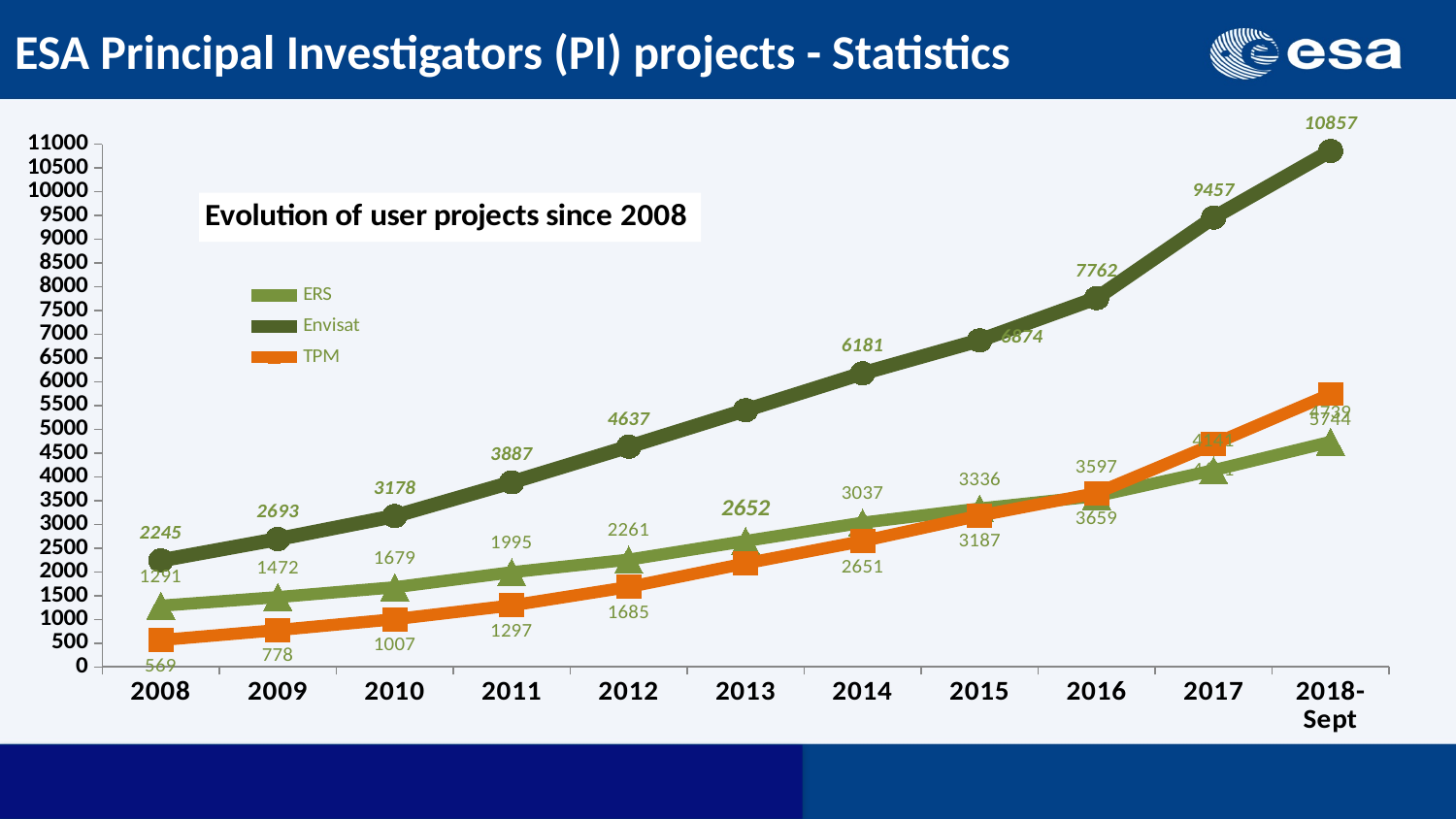
What is the difference between the Envisat values for 2017 and 2016? 1695 What is the title of the chart? Evolution of user projects since 2008 In which year does the Envisat series reach its highest value? 2018-Sept Is the Envisat value for 2013 greater or less than 5000? greater How many series does the legend list? 3 What is the Envisat value for 2018-Sept? 10857 What is the ERS value for 2013? 2652 What is the Envisat value for 2008? 2245 How many time points are shown along the x axis? 11 What kind of chart is shown on the slide? line chart What is the TPM value for 2008? 569 In 2014, which series has the larger value, ERS or TPM? ERS